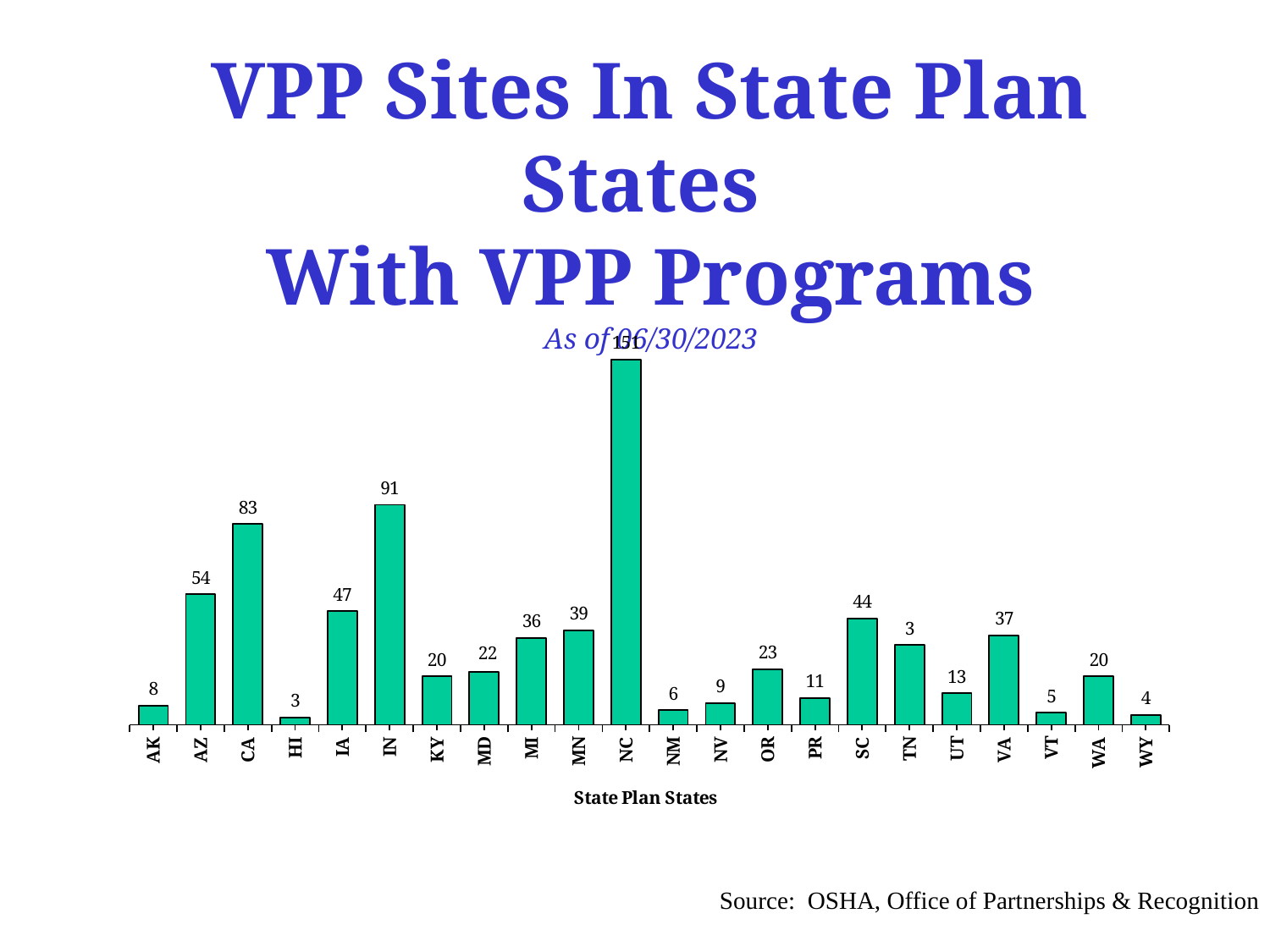
What is the value shown for AZ? 54 What is the title of the x axis? State Plan States What kind of chart is shown on the slide? Bar chart How many VPP sites does CA have? 83 How many states are shown on the x axis? 22 What is the value shown for WY? 4 What is the difference between the values for AZ and IA? 7 Which state has the highest number of VPP sites? NC What is the value shown for IN? 91 How many VPP sites does SC have? 44 Which has a higher value, MI or MN? MN What is the difference between the values for IN and CA? 8